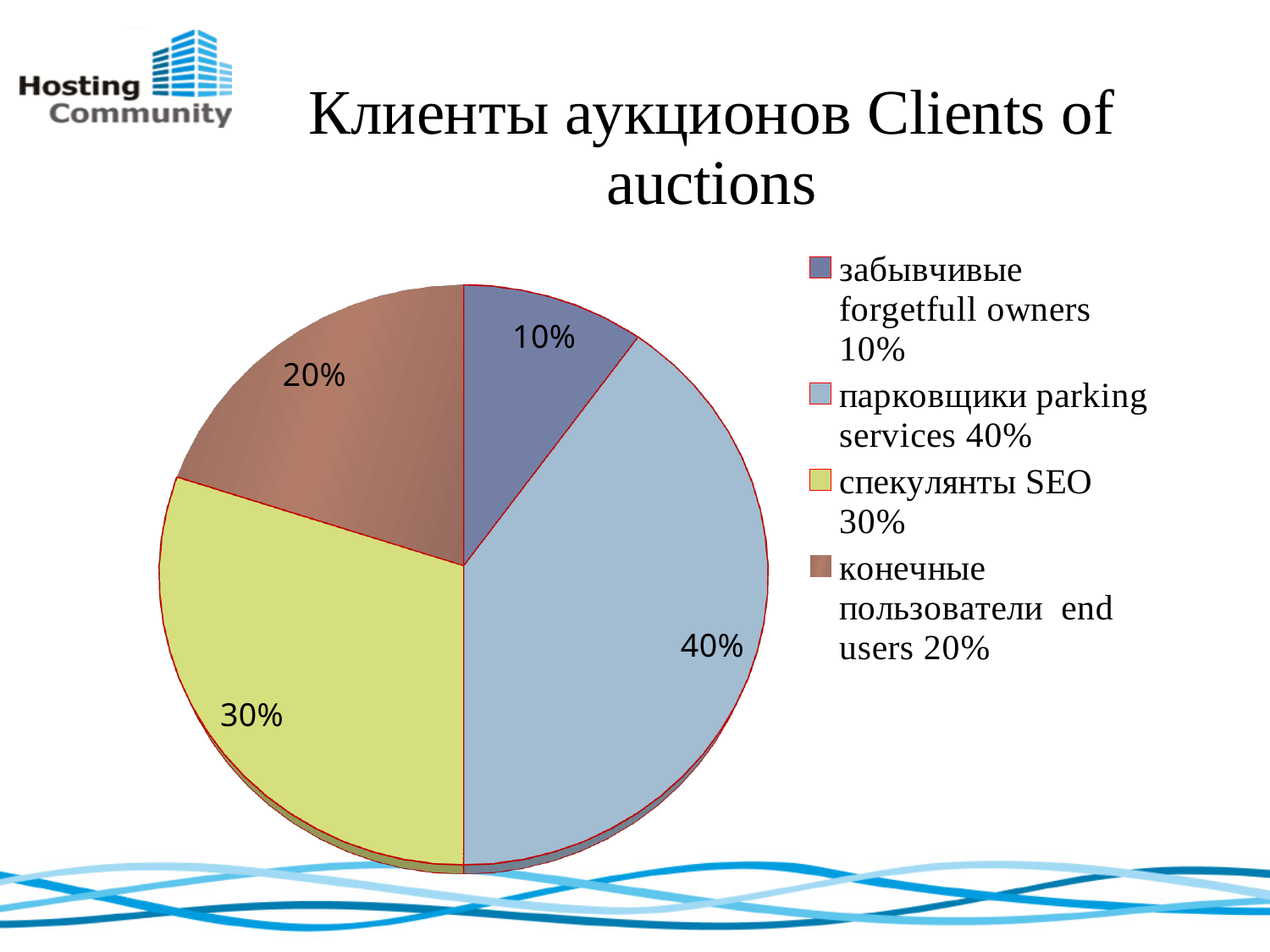
How many slices does the pie chart have? 4 Which category has the smallest slice of the pie? забывчивые forgetfull owners What share of the pie does 'забывчивые forgetfull owners' have? 10% What share of the pie does 'конечные пользователи end users' have? 20% What is the difference between the shares of 'парковщики parking services' and 'спекулянты SEO'? 10% Which is larger: the share of 'конечные пользователи end users' or 'забывчивые forgetfull owners'? конечные пользователи end users Which category has the largest slice of the pie? парковщики parking services What is the title of the slide containing the chart? Клиенты аукционов Clients of auctions What share of the pie does 'парковщики parking services' have? 40% What share of the pie does 'спекулянты SEO' have? 30% How many entries does the legend list? 4 What kind of chart is shown on the slide? pie chart